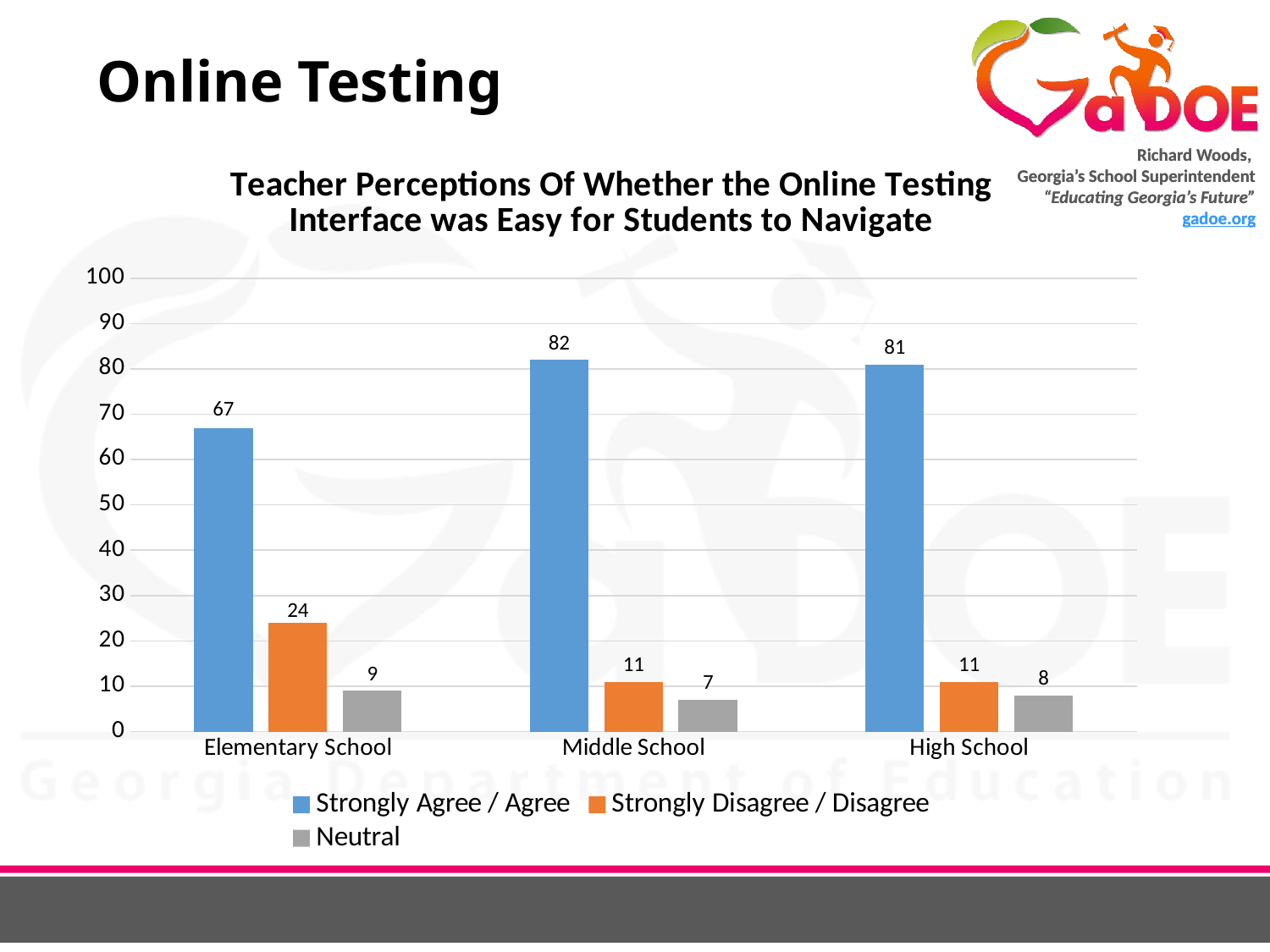
Which school level has the highest Strongly Agree / Agree value? Middle School What is the Neutral value for High School? 8 How many series does the legend list? 3 What is the difference between the Strongly Agree / Agree values for Middle School and Elementary School? 15 What is the Strongly Agree / Agree value for Elementary School? 67 What is the Strongly Disagree / Disagree value for Middle School? 11 Which school level has the lowest Neutral value? Middle School Is the Strongly Agree / Agree value for High School greater or less than 70? greater Which is larger: the Strongly Disagree / Disagree value for Elementary School or for High School? Elementary School How many school levels are shown on the x axis? 3 What kind of chart is shown on the slide? Bar chart Which colour represents the Neutral series? Gray